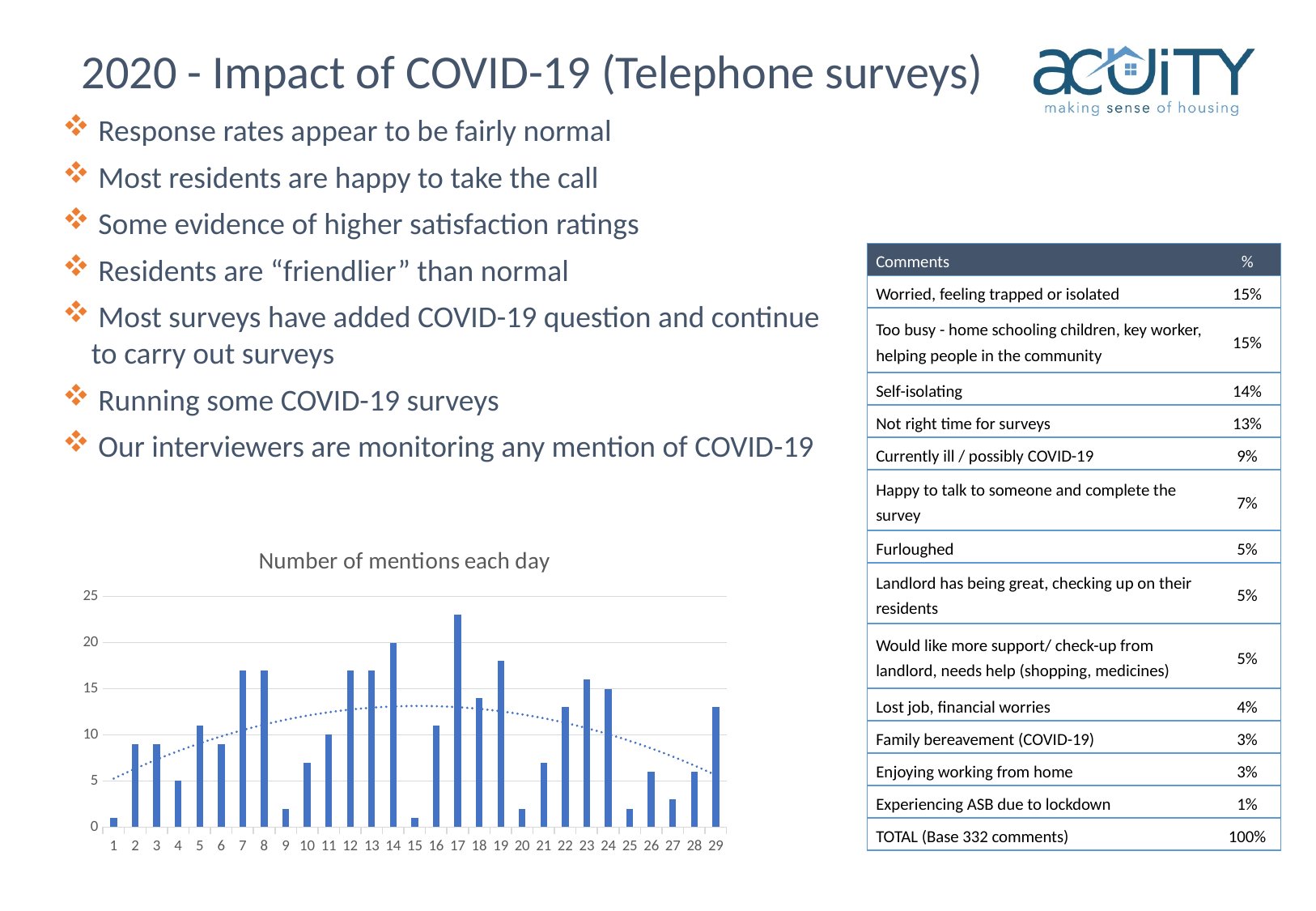
How many days are shown on the x axis of the chart? 29 Which day has the highest number of mentions? 17 Is the number of mentions on day 9 greater or less than 5? less Which day has more mentions, day 14 or day 10? 14 What is the title of the chart on the slide? Number of mentions each day Is the number of mentions on day 17 greater or less than 20? greater Is the number of mentions on day 7 greater or less than 15? greater Which day has more mentions, day 23 or day 26? 23 What is the highest value shown on the y axis of the chart? 25 What kind of chart is used to show the number of mentions each day? Bar chart